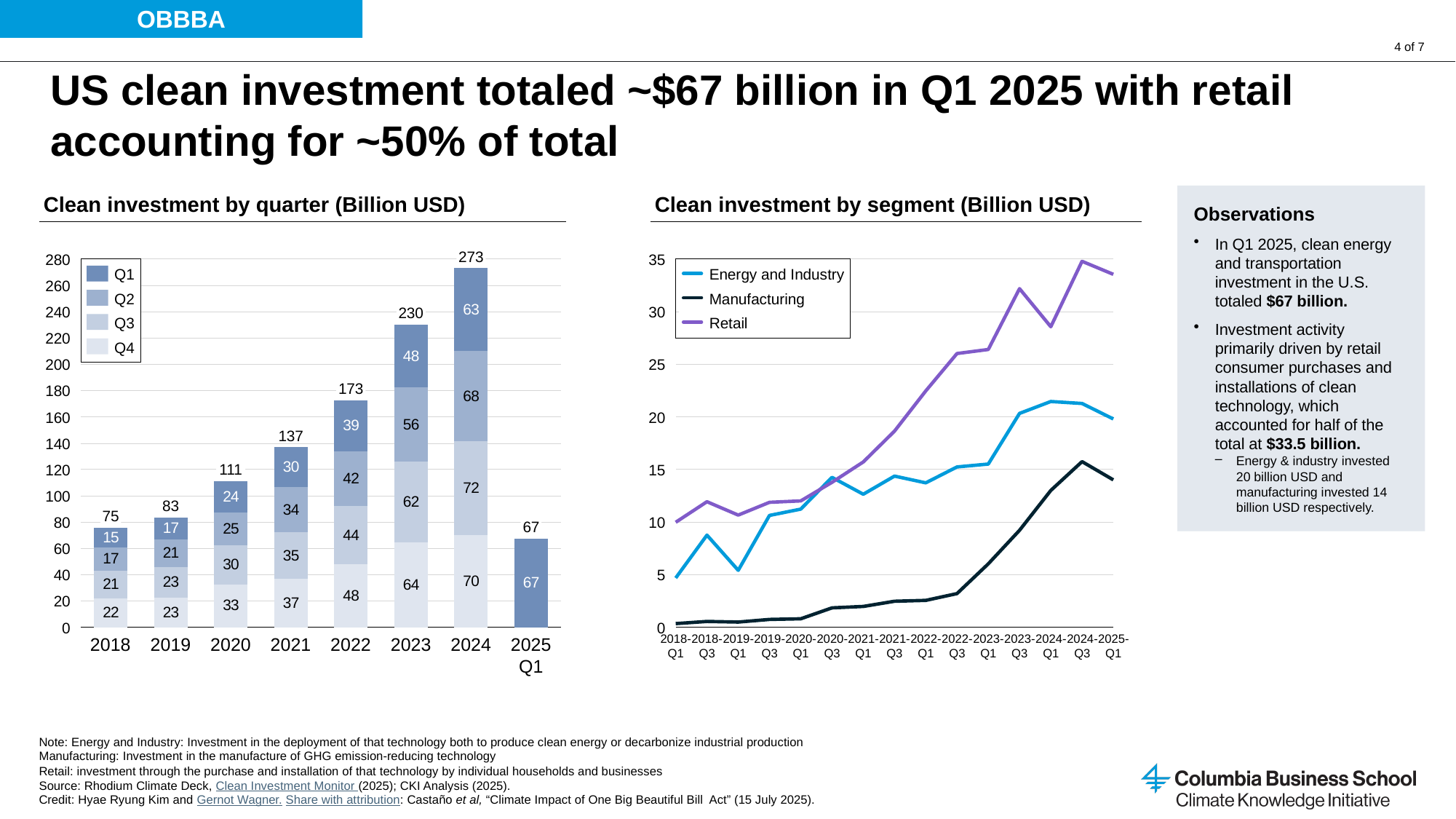
In the 'Clean investment by quarter' chart, what is the total for 2018? 75 In the 'Clean investment by quarter' chart, which total is larger, 2020 or 2021? 2021 In the 'Clean investment by quarter' chart, how many series does the legend list? 4 What kind of chart is 'Clean investment by quarter (Billion USD)'? Stacked bar chart In the 'Clean investment by quarter' chart, which year has the highest total? 2024 In the 'Clean investment by quarter' chart, what is the difference between the 2024 total and the 2023 total? 43 In the 'Clean investment by segment' chart, is the Retail value at 2025-Q1 greater or less than 30? greater In the 'Clean investment by segment' chart, how many series does the legend list? 3 What kind of chart is 'Clean investment by segment (Billion USD)'? Line chart In the 'Clean investment by quarter' chart, how many bars are plotted? 8 In the 'Clean investment by segment' chart, does the Retail line generally rise or fall from 2018-Q1 to 2025-Q1? Rise In the 'Clean investment by quarter' chart, what is the total clean investment for 2024? 273